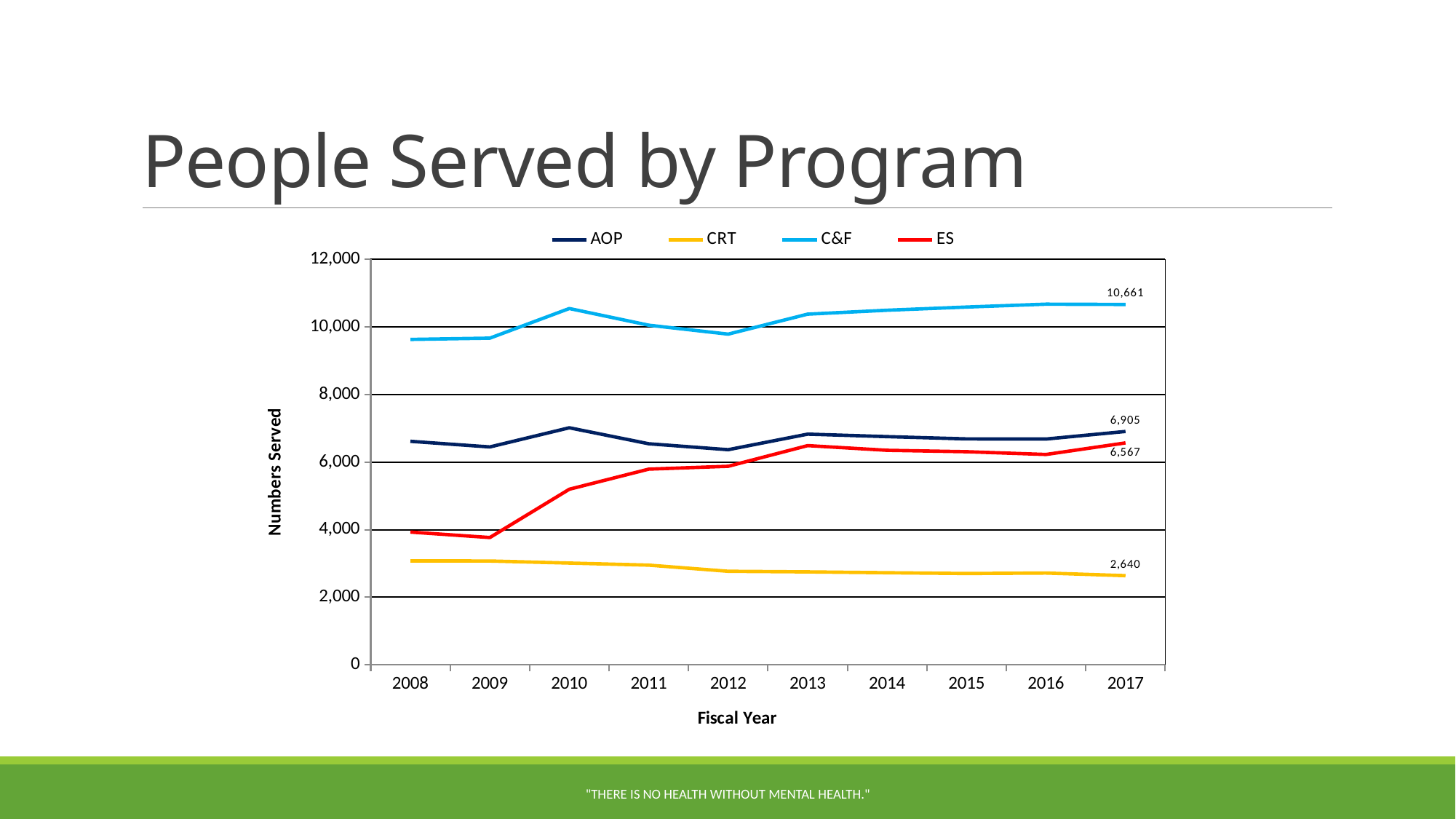
Which program served the most people in 2017? C&F How many series does the legend list? 4 Which program served the fewest people in 2017? CRT What is the difference between the AOP and ES values in 2017? 338 What kind of chart is shown on the slide? line chart Is the value for C&F in 2008 greater or less than 10,000? less What is the value for AOP in 2017? 6,905 What is the value for ES in 2017? 6,567 What is the value for C&F in 2017? 10,661 How many fiscal years are shown on the x axis? 10 What is the value for CRT in 2017? 2,640 Is the value for ES in 2010 greater or less than 4,000? greater